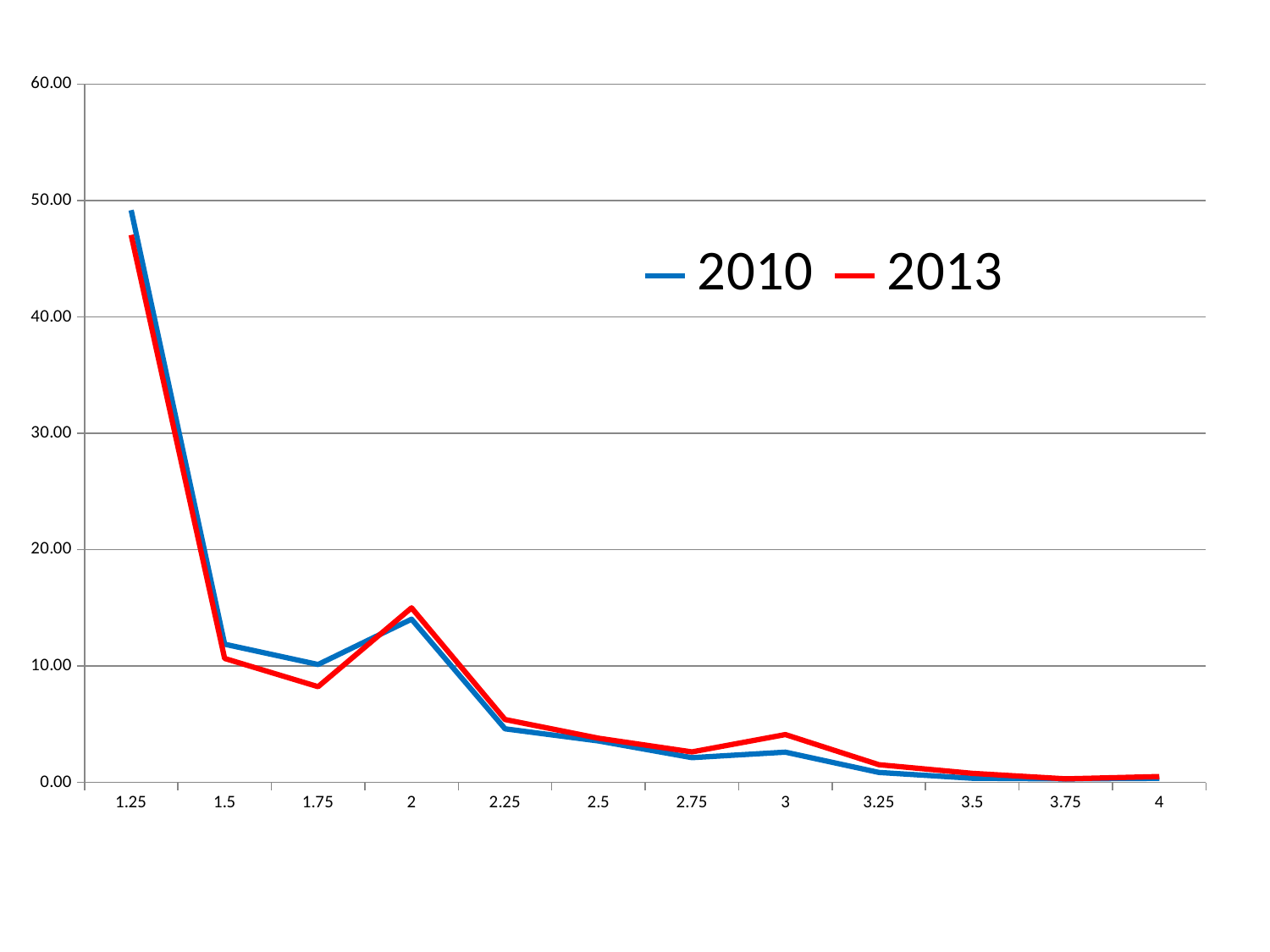
How many series does the legend list? 2 Is the value for 2010 at 1.25 greater or less than 40? greater How many points are plotted along the x axis for each series? 12 At which x-axis value does the 2013 series reach its highest point? 1.25 Overall, do the values rise or fall as the x axis goes from 1.25 to 4? fall At 3, which series has the higher value, 2010 or 2013? 2013 Is the value for 2013 at 2 greater or less than 10? greater Is the value for 2013 at 1.5 greater or less than 20? less At 1.75, which series has the higher value, 2010 or 2013? 2010 What kind of chart is shown on the slide? line chart At which x-axis value does the 2010 series reach its highest point? 1.25 Which colour represents the 2013 series? red